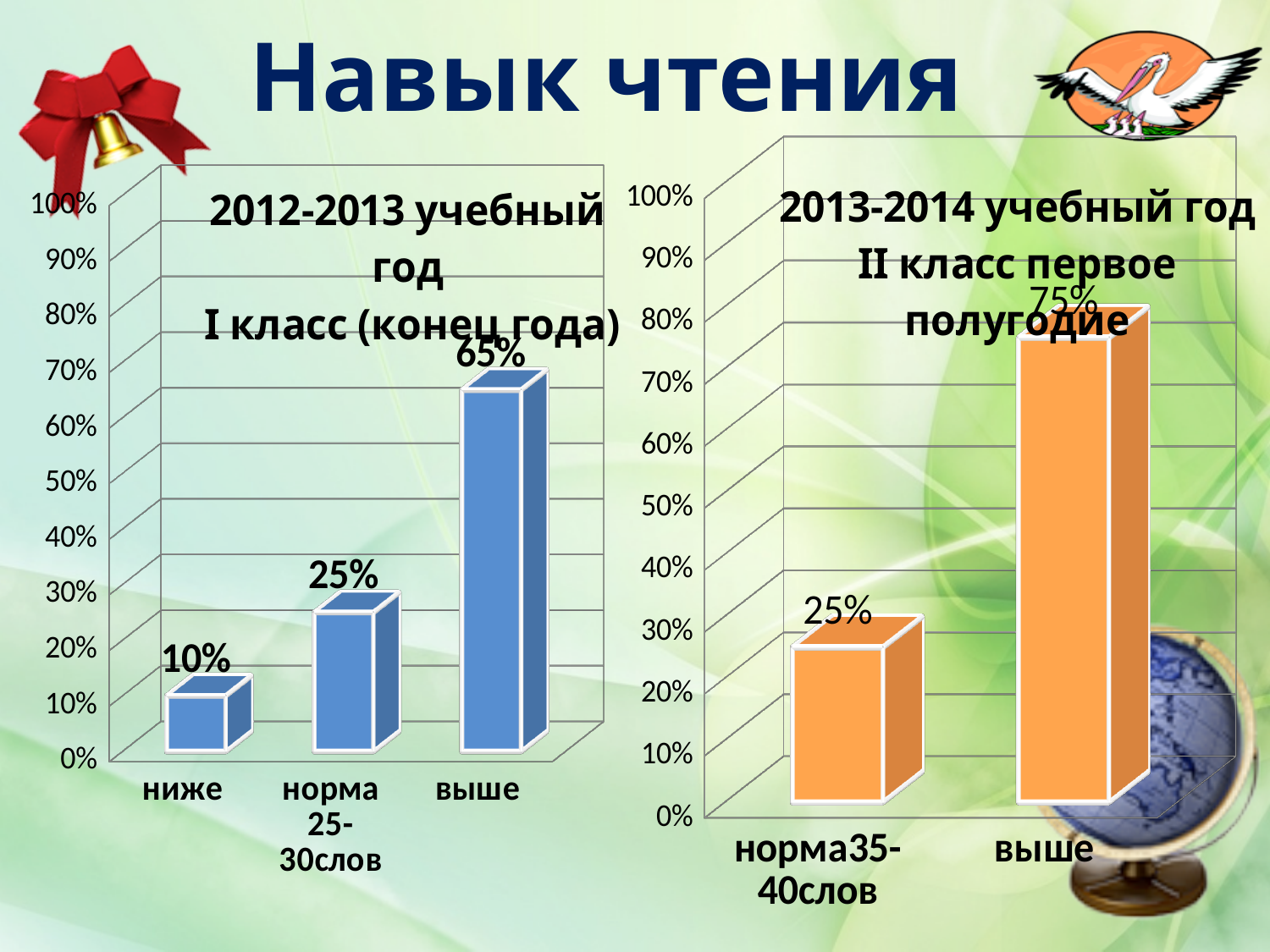
In the right chart (2013-2014 учебный год), what is the value for "выше"? 75% In the left chart (2012-2013 учебный год), what is the value for "ниже"? 10% In the left chart (2012-2013 учебный год), which category has the highest value? выше In the right chart (2013-2014 учебный год), what is the value for "норма35-40слов"? 25% In the left chart (2012-2013 учебный год), which category has the lowest value? ниже What type of chart is the right chart (2013-2014 учебный год)? bar chart How many categories are shown in the left chart (2012-2013 учебный год)? 3 Which is larger: the value for "выше" in the left chart or the value for "выше" in the right chart? the right chart (75%) In the right chart (2013-2014 учебный год), what is the difference between the values for "выше" and "норма35-40слов"? 50% In the left chart (2012-2013 учебный год), what is the value for "выше"? 65% In the left chart (2012-2013 учебный год), what is the difference between the values for "выше" and "норма 25-30слов"? 40% How many categories are shown in the right chart (2013-2014 учебный год)? 2